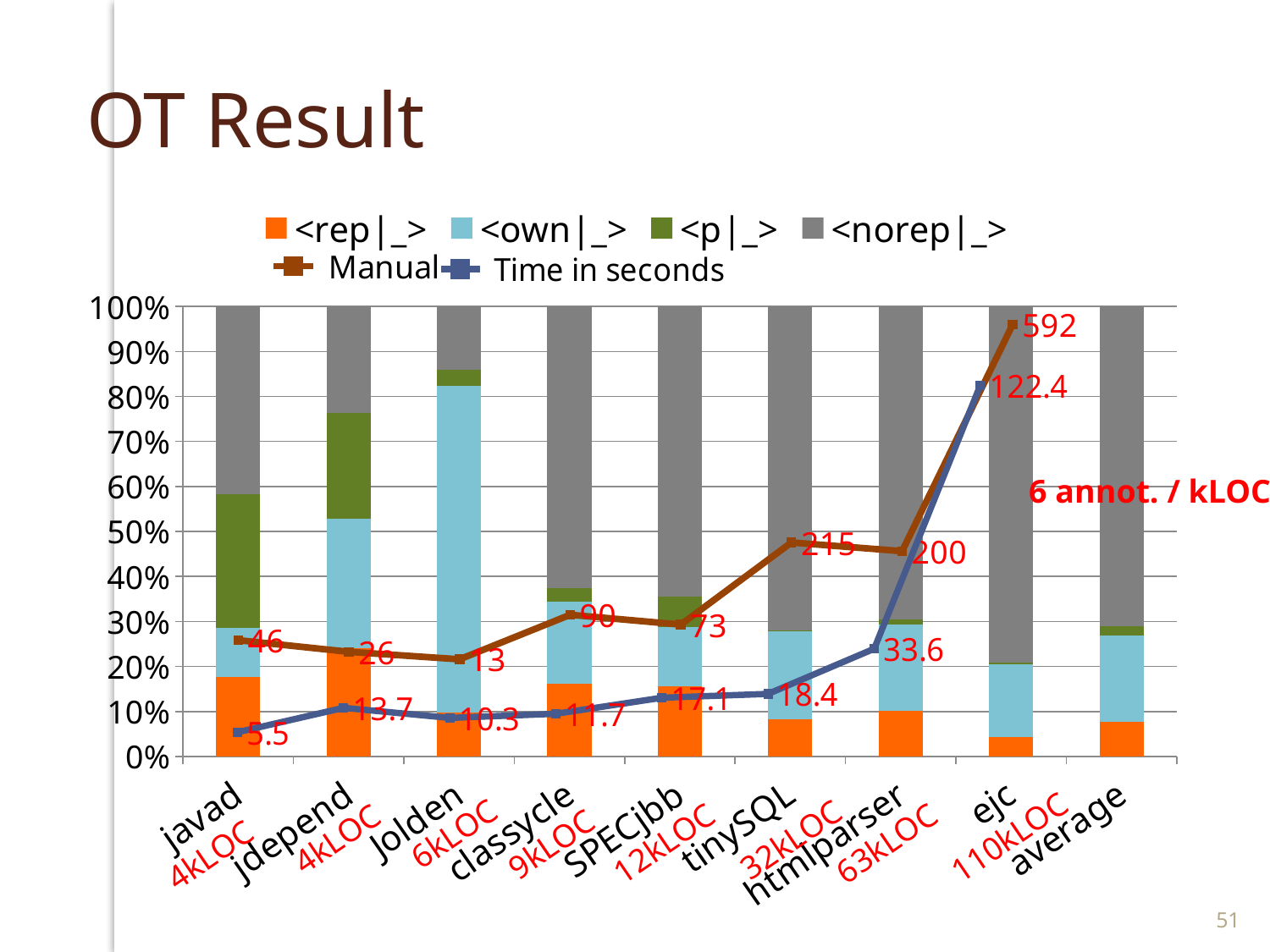
What is the Time in seconds value for htmlparser? 33.6 What is the Manual value for ejc? 592 How many series does the legend list? 6 What is the Manual value for classycle? 90 Which category has the lowest Time in seconds value? javad What colour represents the <rep|_> series in the legend? Orange Which category has the lowest Manual value? Jolden Which is larger, the Manual value for classycle or for SPECjbb? classycle Is the <own|_> share for Jolden greater or less than 50%? greater Which category has the highest Manual value? ejc How many categories are shown on the x axis? 9 What is the difference between the Manual values for tinySQL and htmlparser? 15